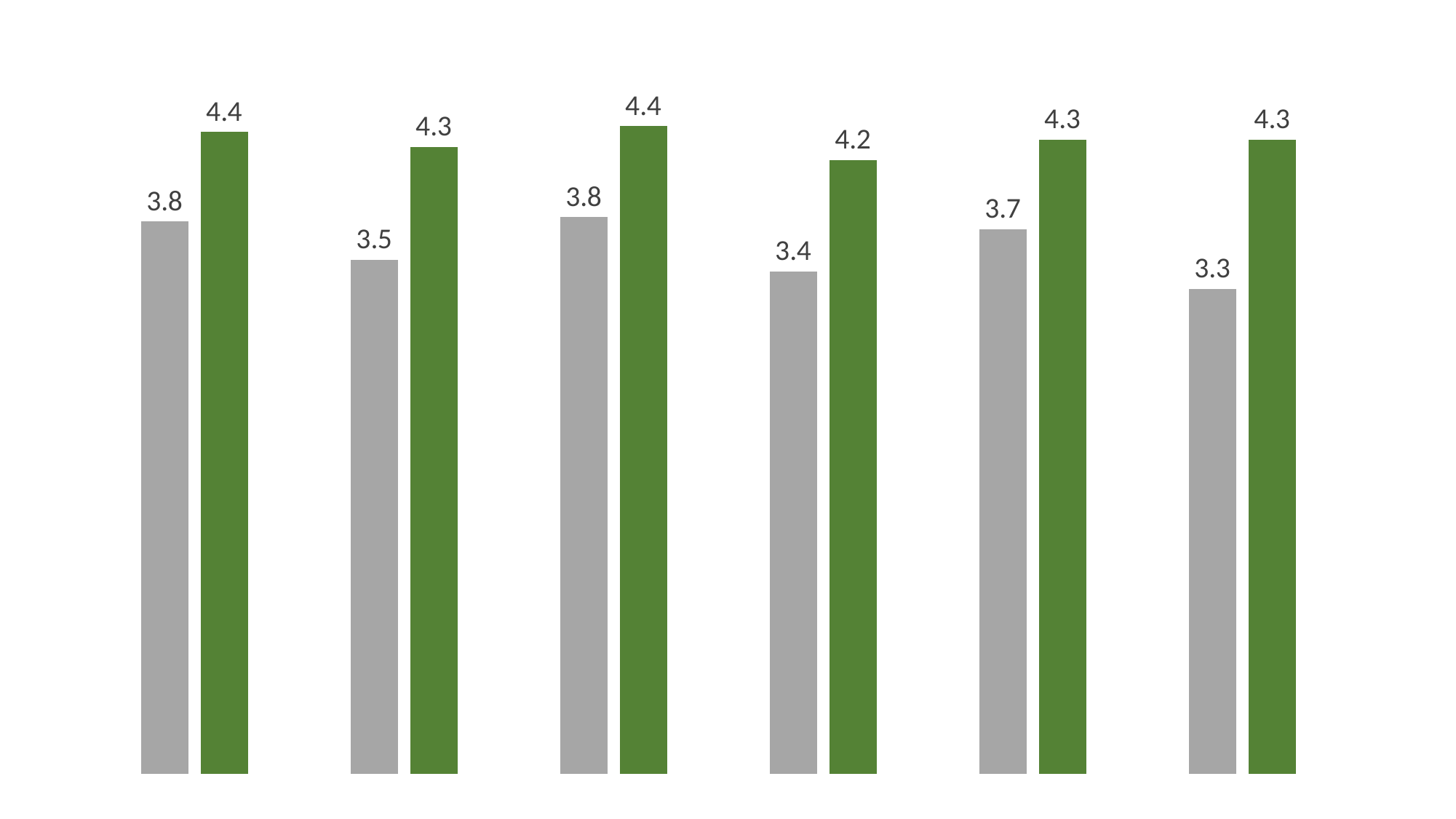
What is the value of the grey bar in the sixth group from the left? 3.3 What is the value of the grey bar in the first group from the left? 3.8 Which group from the left has the lowest grey bar? the sixth group What colours are the two bars in each group? grey and green What is the difference between the green and grey bars in the sixth group from the left? 1.0 What is the value of the green bar in the fourth group from the left? 4.2 What is the value of the green bar in the second group from the left? 4.3 What kind of chart is shown on the slide? bar chart What is the difference between the green and grey bars in the first group from the left? 0.6 How many groups of bars are shown in the chart? 6 In the fifth group from the left, which bar is larger, the grey or the green? the green bar Which group from the left has the lowest green bar? the fourth group